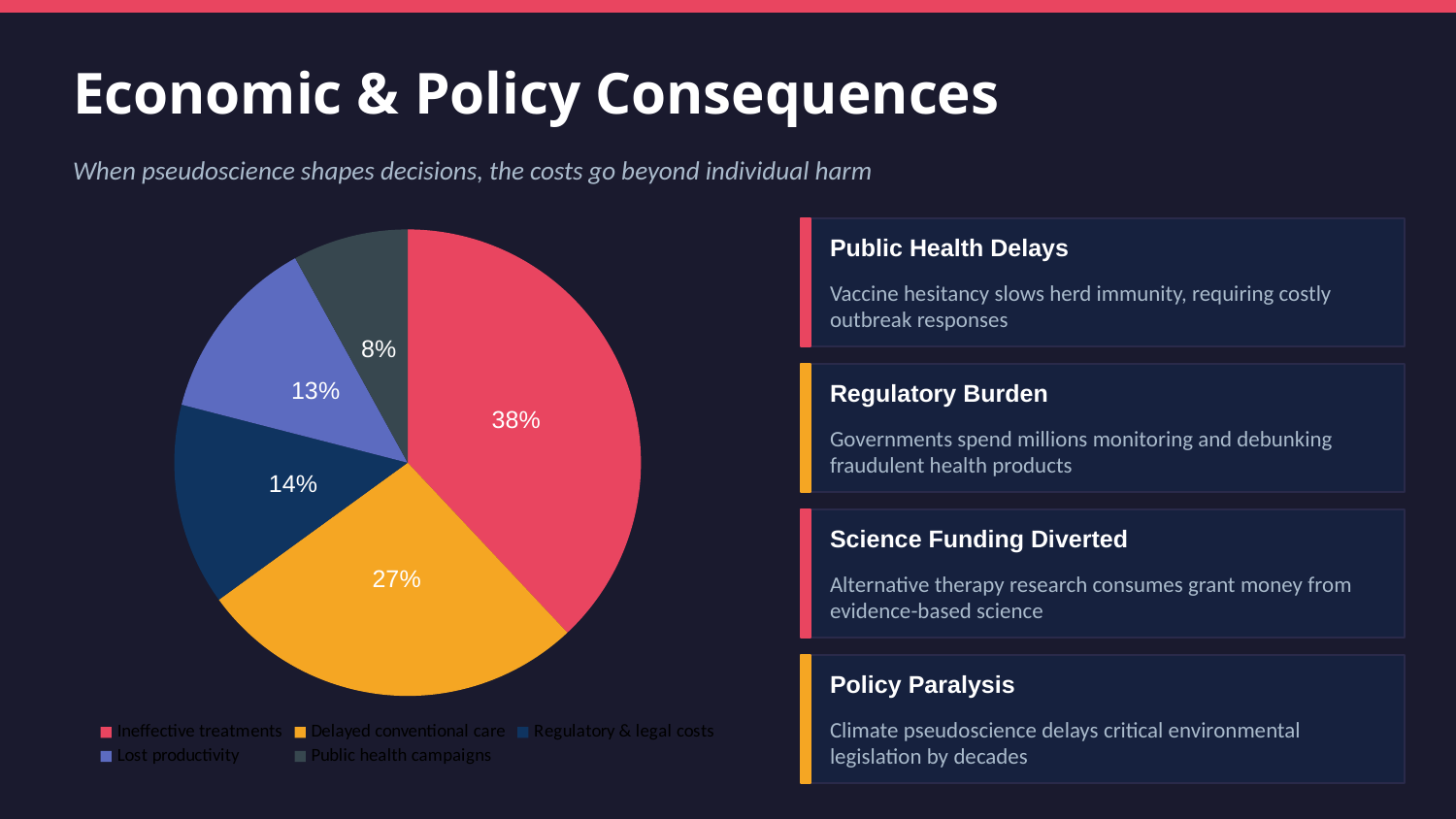
What is the difference between the shares for Ineffective treatments and Delayed conventional care? 11% How many slices does the pie chart have? 5 What is the value shown for Regulatory & legal costs? 14% Which category is shown in orange in the pie chart? Delayed conventional care What share of the pie does Ineffective treatments account for? 38% Which category has the largest slice of the pie? Ineffective treatments What kind of chart is shown on the slide? pie chart What is the value shown for Lost productivity? 13% What is the value shown for Delayed conventional care? 27% What is the value shown for Public health campaigns? 8% Which is larger, the share for Delayed conventional care or the share for Regulatory & legal costs? Delayed conventional care Which category has the smallest slice of the pie? Public health campaigns